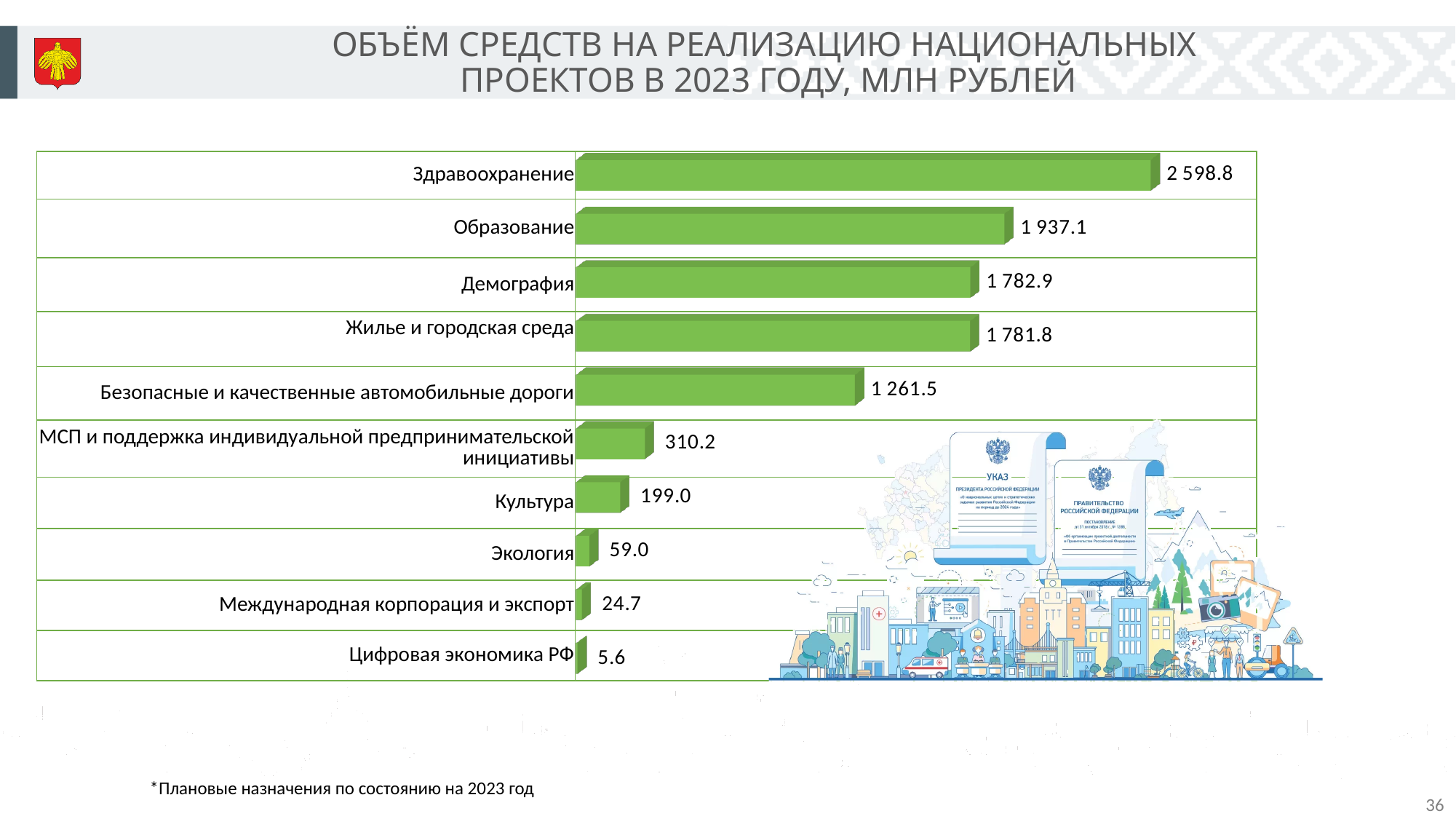
What is the value for Культура? 199.0 How many categories are shown in the chart? 10 What kind of chart is shown on the slide? Bar chart What is the difference between the values for Здравоохранение and Образование? 661.7 What is the value for Образование? 1 937.1 What is the value for Безопасные и качественные автомобильные дороги? 1 261.5 What is the difference between the values for Культура and Экология? 140.0 What is the value for Здравоохранение? 2 598.8 What is the value for Цифровая экономика РФ? 5.6 Which category has the highest value? Здравоохранение Which is larger, the value for Экология or the value for Международная корпорация и экспорт? Экология Which category has the lowest value? Цифровая экономика РФ